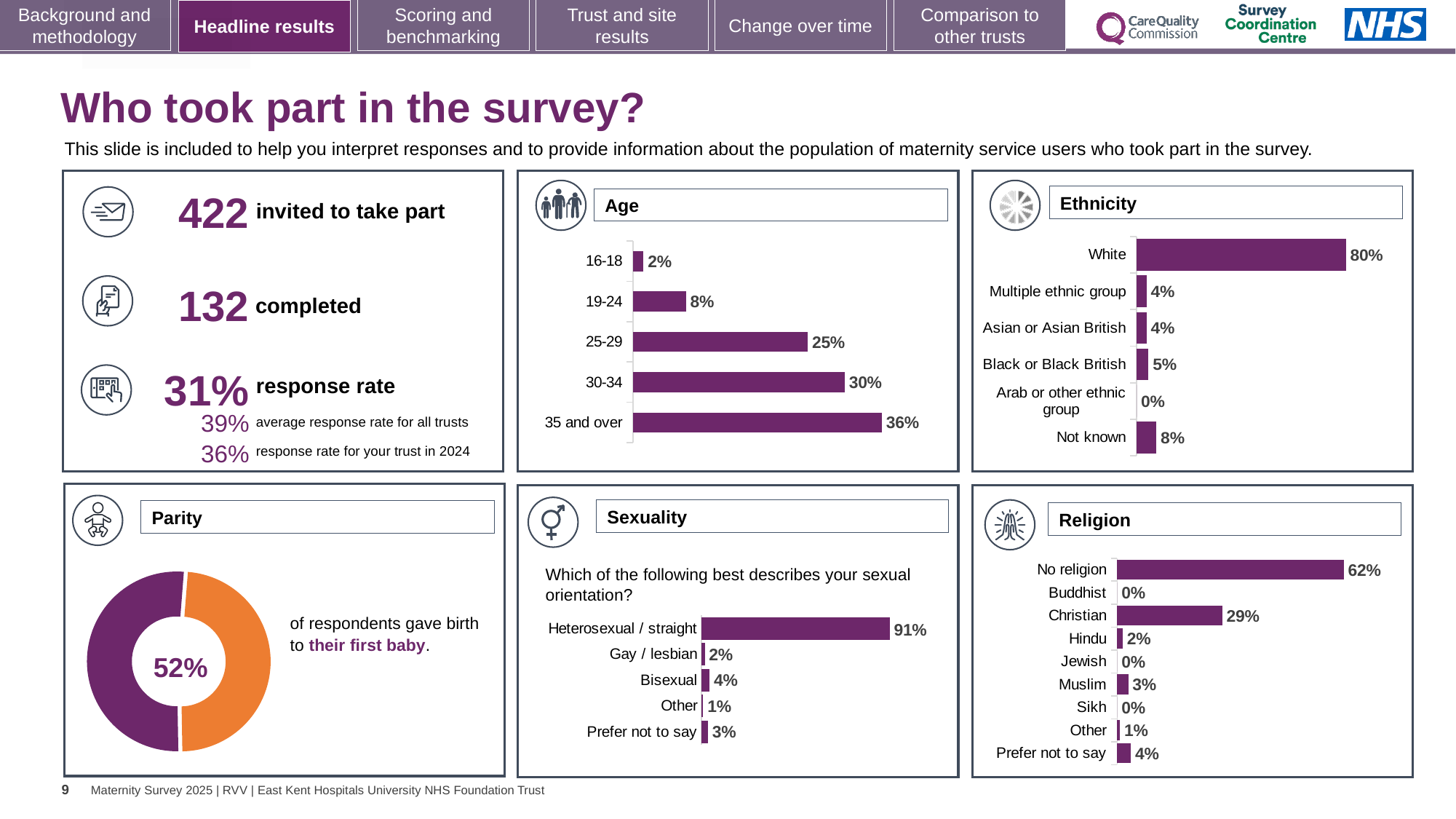
In the Parity chart, what percentage of respondents gave birth to their first baby? 52% In the Ethnicity chart, which is larger: Black or Black British or Multiple ethnic group? Black or Black British In the Ethnicity chart, what percentage of respondents were White? 80% In the Ethnicity chart, how many ethnic categories are shown? 6 In the Religion chart, what percentage of respondents were Christian? 29% In the Religion chart, which category has the highest percentage? No religion In the Age chart, what percentage of respondents were aged 35 and over? 36% What kind of chart is the Parity chart? Doughnut chart In the Sexuality chart, what is the difference between Bisexual and Gay / lesbian? 2% In the Age chart, which age group has the lowest percentage? 16-18 In the Sexuality chart, what percentage of respondents answered Heterosexual / straight? 91% In the Age chart, what is the difference between the 30-34 and 25-29 percentages? 5%